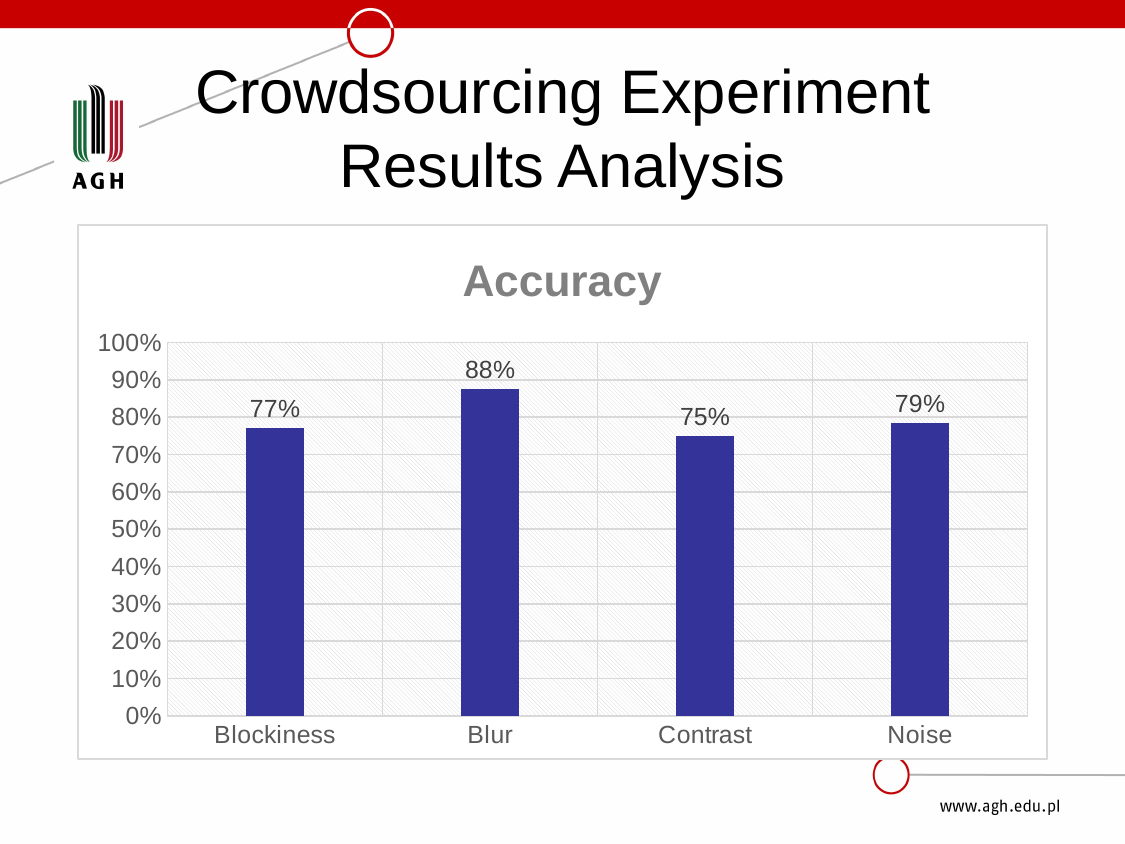
What is the difference in accuracy between Noise and Blockiness? 2% Which category has the lowest accuracy? Contrast How many categories are shown in the chart? 4 What is the accuracy value for Blur? 88% What is the accuracy value for Contrast? 75% What is the accuracy value for Noise? 79% Is the accuracy for Contrast greater or less than 80%? less What is the difference in accuracy between Blur and Contrast? 13% What is the accuracy value for Blockiness? 77% Which category has the highest accuracy? Blur Which has a higher accuracy, Blockiness or Noise? Noise What type of chart is shown on the slide? Bar chart